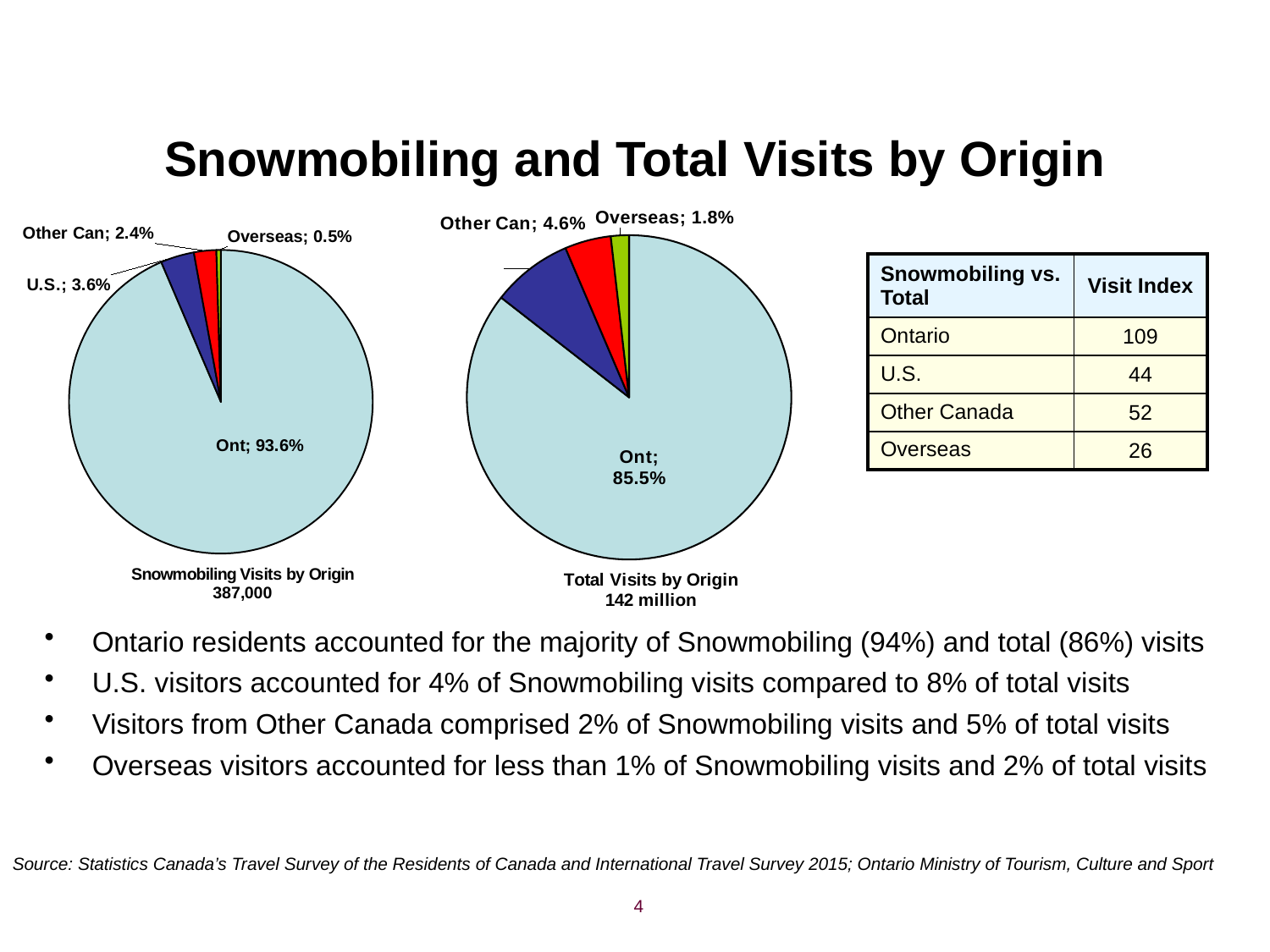
In the 'Total Visits by Origin' chart, which origin has the largest slice? Ont How many slices does the 'Snowmobiling Visits by Origin' pie chart have? 4 In the 'Total Visits by Origin' chart, what share of visits is from Overseas? 1.8% In the 'Total Visits by Origin' chart, which is larger, the Other Can share or the Overseas share? Other Can In the 'Snowmobiling Visits by Origin' chart, which origin has the smallest slice? Overseas What kind of chart is the 'Snowmobiling Visits by Origin' chart? pie chart What total number of visits is shown under the 'Total Visits by Origin' chart? 142 million In the 'Total Visits by Origin' chart, what share of visits is from Ontario? 85.5% In the 'Snowmobiling Visits by Origin' chart, what share of visits is from the U.S.? 3.6% In the 'Snowmobiling Visits by Origin' chart, what is the difference between the U.S. share and the Other Can share? 1.2% In the 'Snowmobiling Visits by Origin' chart, what share of visits is from Ontario? 93.6% In the 'Snowmobiling Visits by Origin' chart, what share of visits is from Other Canada? 2.4%